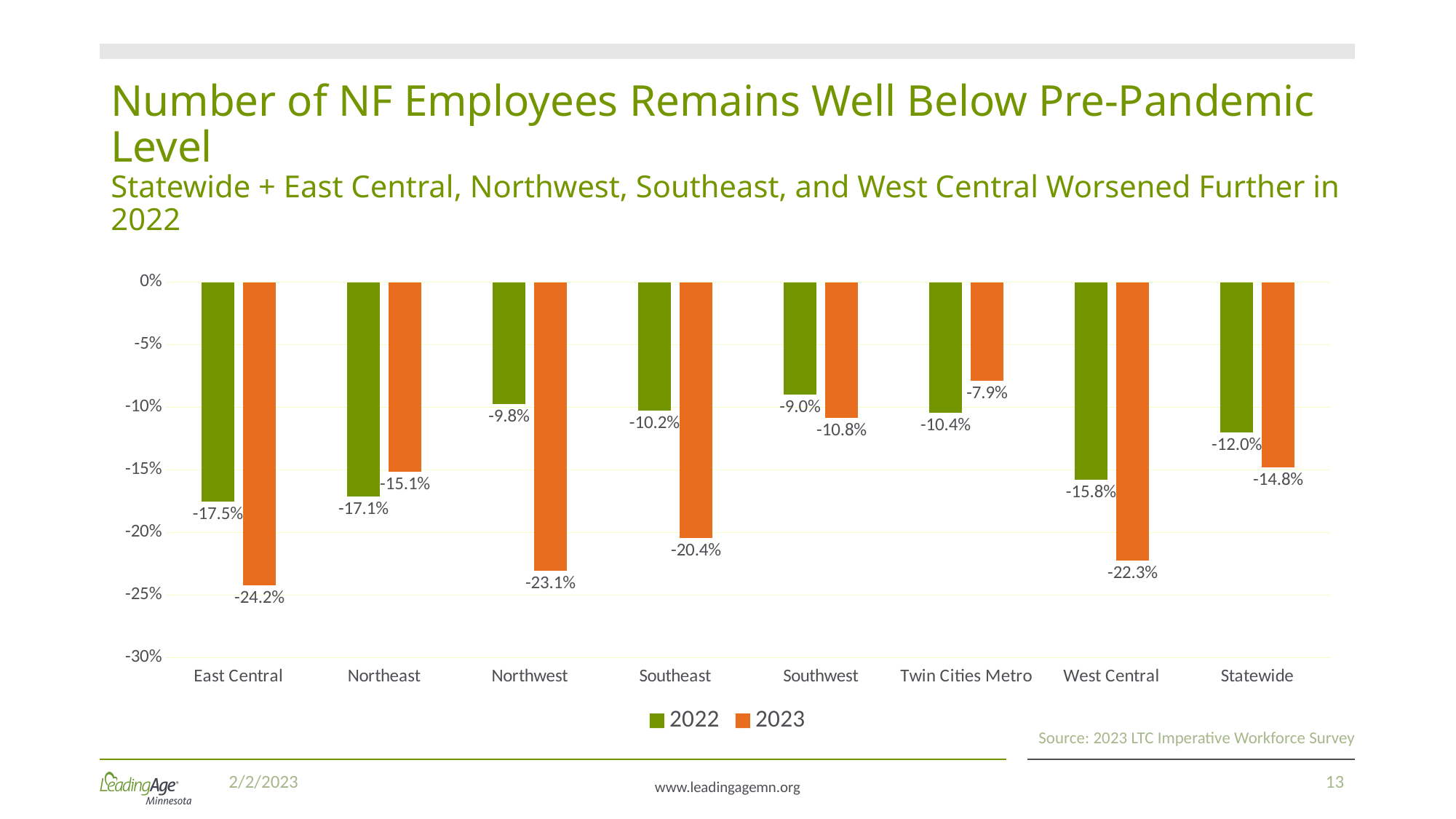
How many series does the legend list? 2 What is the 2022 value for Statewide? -12.0% What colour represents the 2023 series in the legend? Orange Which category has the highest (least negative) 2023 value? Twin Cities Metro What kind of chart is shown on the slide? Bar chart Which category has the highest (least negative) 2022 value? Southwest How many categories are shown on the x axis? 8 Which region has the lowest (most negative) 2023 value? East Central What is the difference in percentage points between the 2022 and 2023 values for Northwest? 13.3 percentage points For Northeast, which year shows the larger decline, 2022 or 2023? 2022 What is the 2023 value for East Central? -24.2% What is the 2023 value for Twin Cities Metro? -7.9%